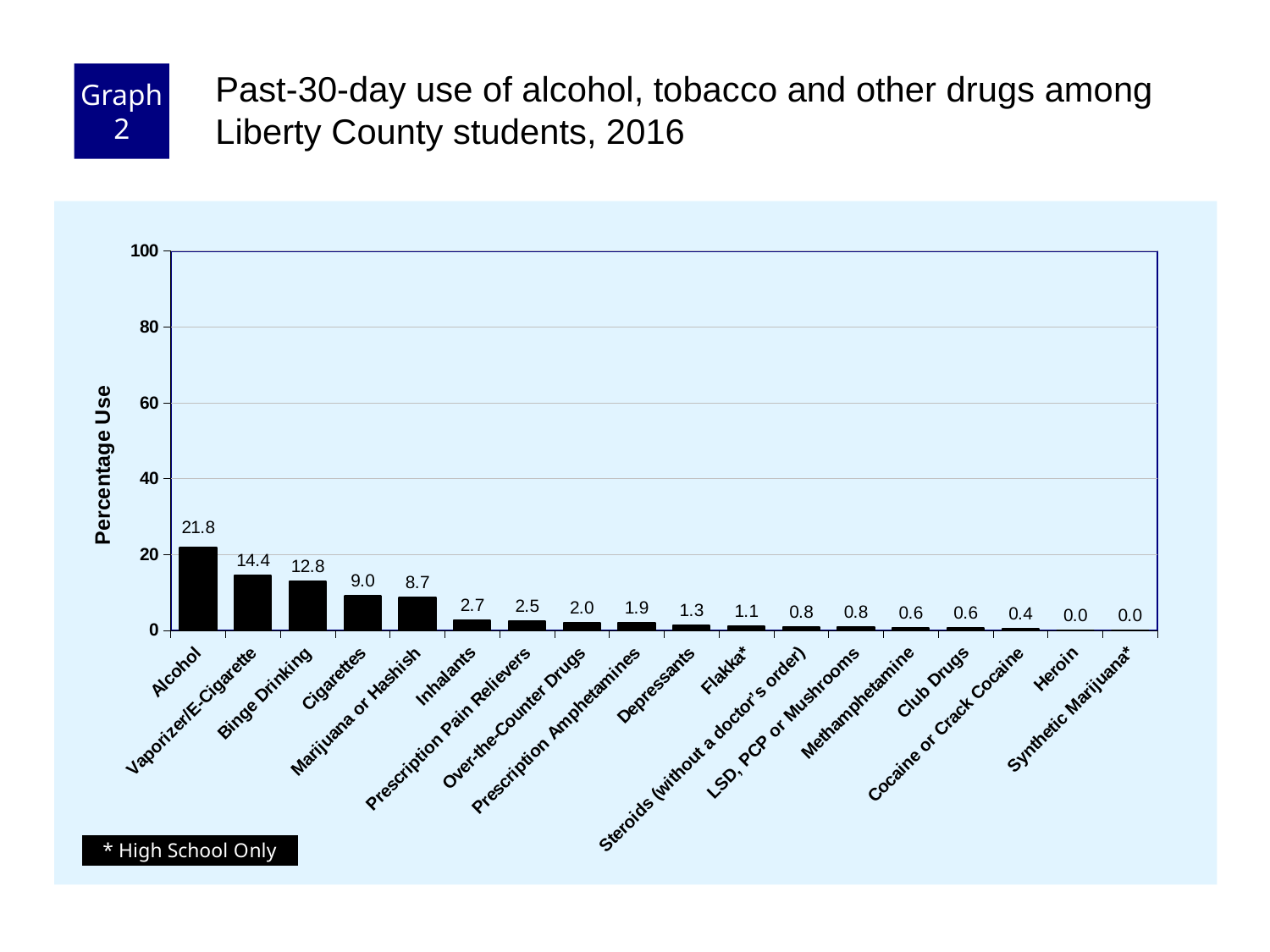
What is the percentage use for Inhalants? 2.7 Which has a higher percentage use, Cigarettes or Marijuana or Hashish? Cigarettes What is the percentage use for Vaporizer/E-Cigarette? 14.4 What is the percentage use for Alcohol? 21.8 Which category has the highest percentage use? Alcohol Do the values rise or fall moving left to right along the x axis? fall How many categories are shown on the x axis? 18 Is the value for Vaporizer/E-Cigarette greater or less than 20? less What is the percentage use for Marijuana or Hashish? 8.7 What is the label of the y axis? Percentage Use What is the difference in percentage use between Alcohol and Binge Drinking? 9.0 What kind of chart is shown on the slide? bar chart